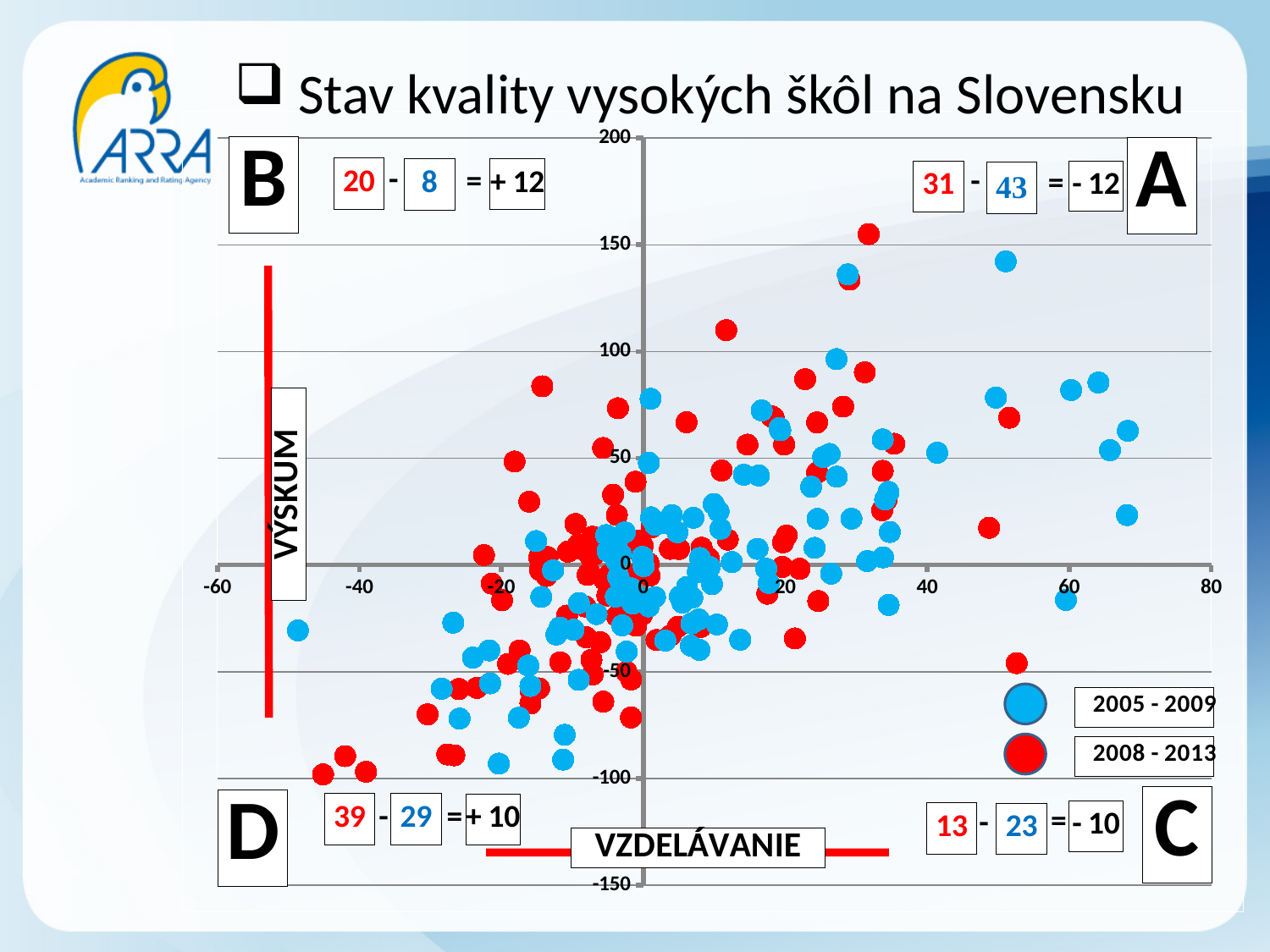
What are the two series named in the legend? 2005 - 2009 and 2008 - 2013 What kind of chart is shown on the slide? scatter plot What is the difference shown for quadrant C (red minus blue)? - 10 Which series is shown in red? 2008 - 2013 What is the label of the horizontal axis? VZDELÁVANIE How many blue (2005 - 2009) points are counted in quadrant A? 43 Is the VÝSKUM value of the highest blue (2005 - 2009) point greater or less than 150? less How many series does the legend list? 2 What is the label of the vertical axis? VÝSKUM How many blue (2005 - 2009) points are counted in quadrant D? 29 What is the difference shown for quadrant B (red minus blue)? + 12 How many red (2008 - 2013) points are counted in quadrant A? 31